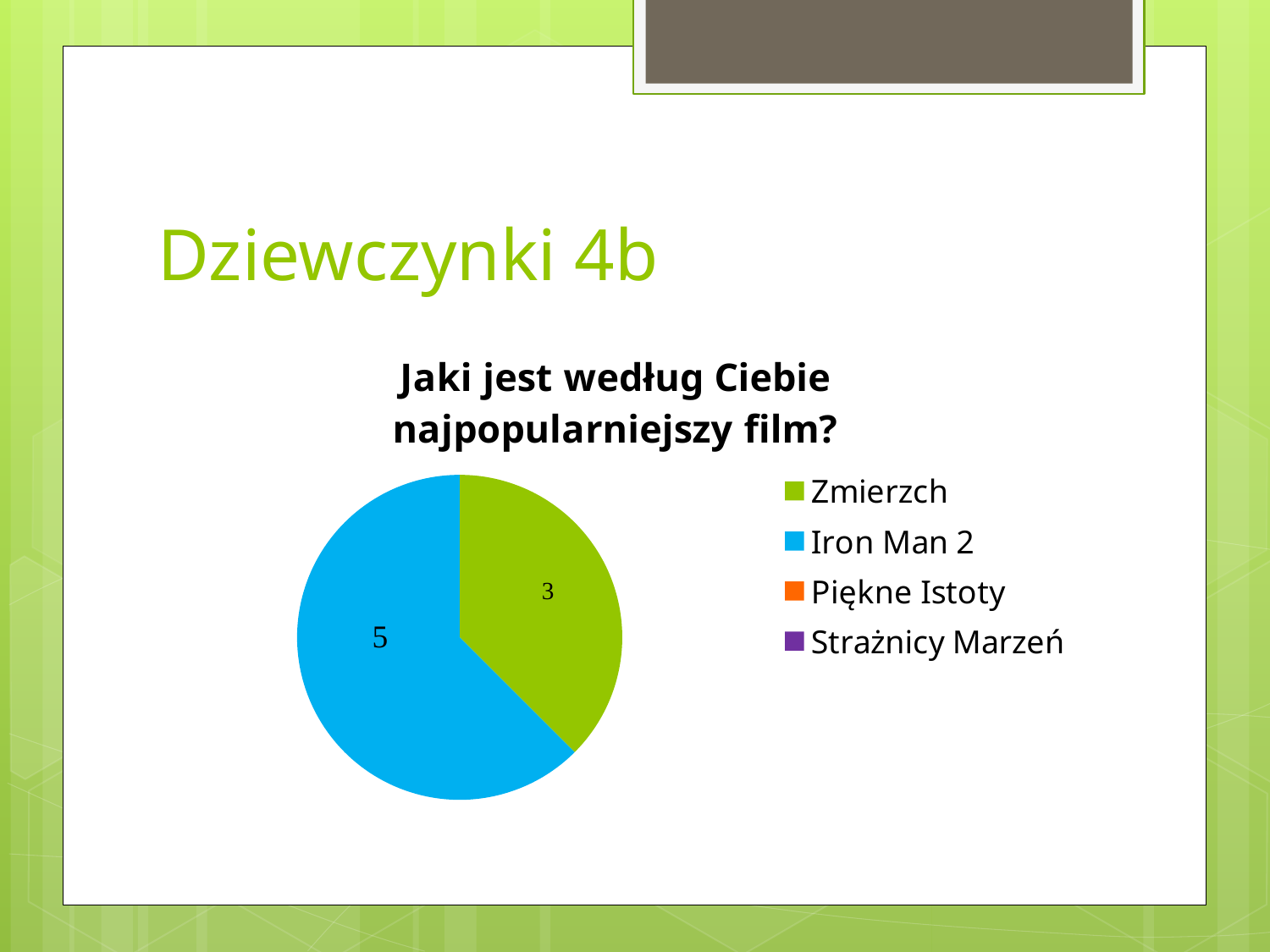
What share of the pie does Iron Man 2 represent? 62.5% What is the value for Iron Man 2 in the pie chart? 5 Which of the two labelled slices is smaller, Zmierzch or Iron Man 2? Zmierzch Which film has the largest slice in the pie chart? Iron Man 2 What is the difference between the values for Iron Man 2 and Zmierzch? 2 What is the value for Zmierzch in the pie chart? 3 Which is larger, the value for Zmierzch or the value for Iron Man 2? Iron Man 2 How many categories does the legend of the pie chart list? 4 What is the title of the pie chart? Jaki jest według Ciebie najpopularniejszy film? How many slices are visible in the pie chart? 2 What is the total of the values shown in the pie chart? 8 What type of chart is shown on the slide? pie chart